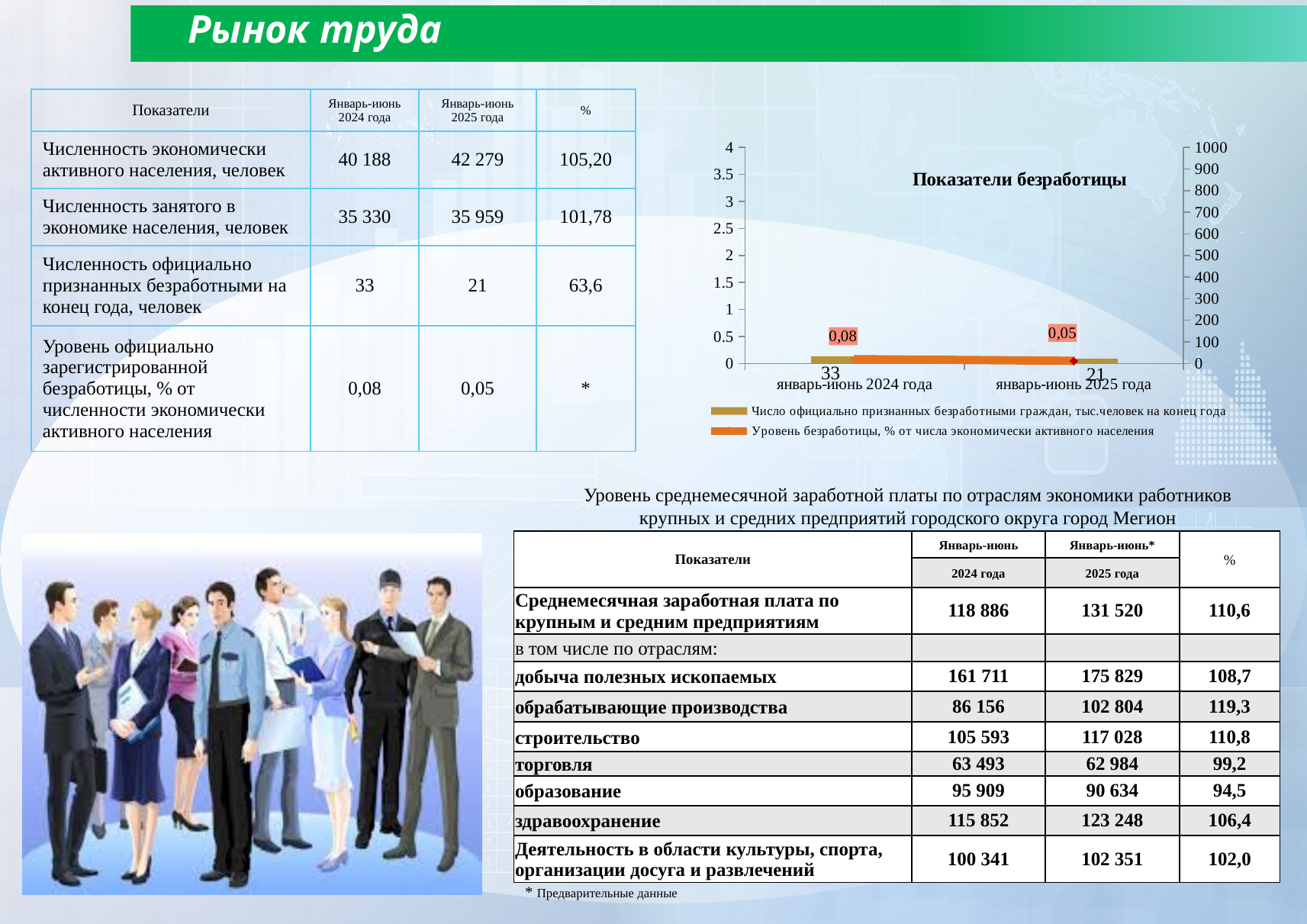
In the chart 'Показатели безработицы', what is the number of officially recognized unemployed citizens for январь-июнь 2024 года? 33 In the chart 'Показатели безработицы', what is the number of officially recognized unemployed citizens for январь-июнь 2025 года? 21 In the chart 'Показатели безработицы', what is the unemployment rate (Уровень безработицы) for январь-июнь 2025 года? 0,05 What kind of chart is 'Показатели безработицы'? Bar and line chart How many periods (categories) are shown on the x axis of the chart 'Показатели безработицы'? 2 In the chart 'Показатели безработицы', what is the unemployment rate (Уровень безработицы) for январь-июнь 2024 года? 0,08 In the chart 'Показатели безработицы', which period has the larger number of officially recognized unemployed citizens? январь-июнь 2024 года In the chart 'Показатели безработицы', in which period is the unemployment rate highest? январь-июнь 2024 года How many series does the legend of the chart 'Показатели безработицы' list? 2 In the chart 'Показатели безработицы', what is the difference between the unemployment rate for январь-июнь 2024 года and январь-июнь 2025 года? 0,03 In the chart 'Показатели безработицы', by how much did the number of officially recognized unemployed citizens decrease from январь-июнь 2024 года to январь-июнь 2025 года? 12 In the chart 'Показатели безработицы', does the unemployment rate rise or fall from январь-июнь 2024 года to январь-июнь 2025 года? Fall